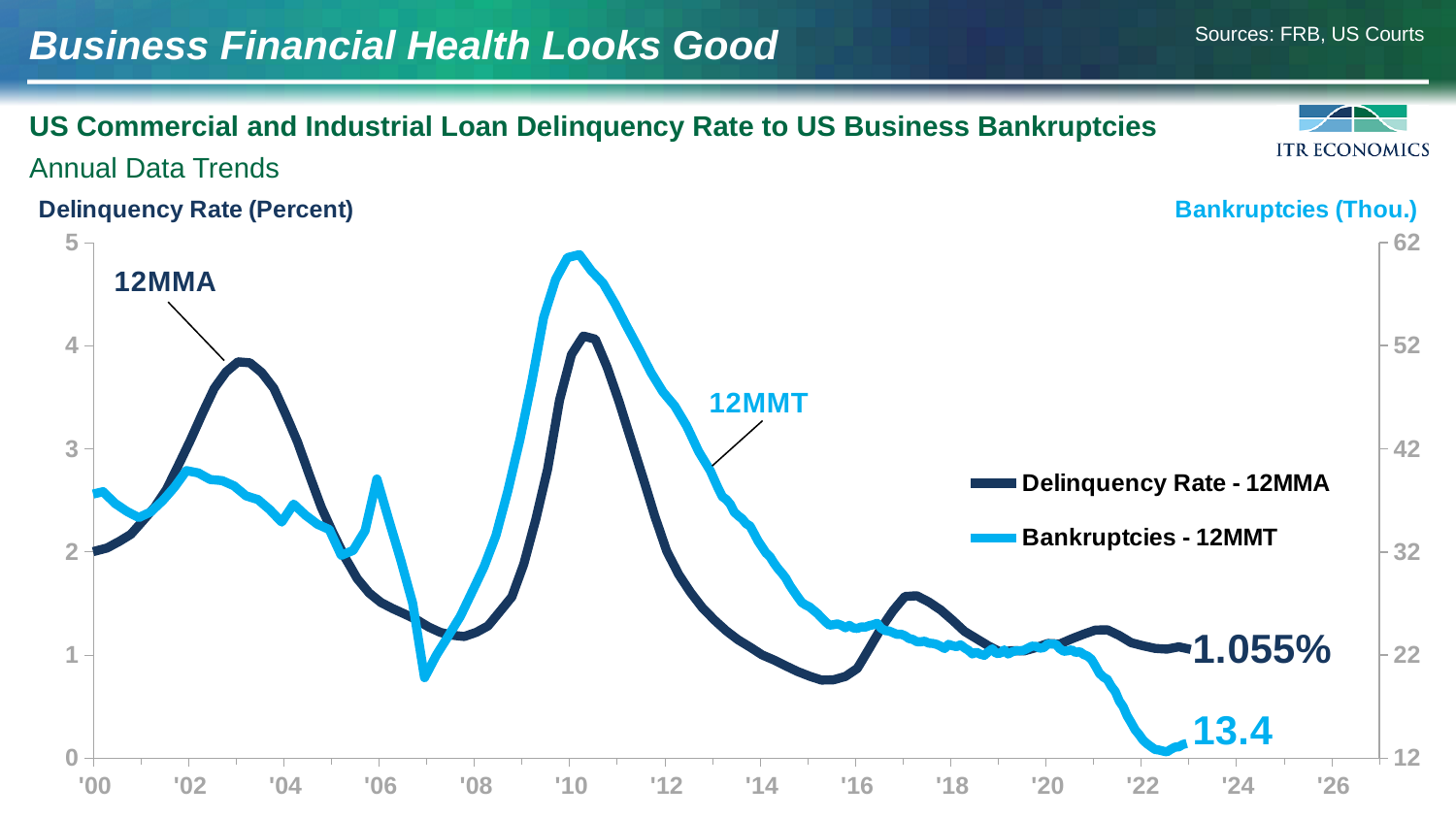
What is the latest value labeled for the Delinquency Rate - 12MMA series? 1.055% What is the label of the right-hand vertical axis? Bankruptcies (Thou.) Does the Delinquency Rate - 12MMA series rise or fall between '10 and '15? fall What is the latest value labeled for the Bankruptcies - 12MMT series? 13.4 What is the title of the chart? US Commercial and Industrial Loan Delinquency Rate to US Business Bankruptcies Is the peak value of the Bankruptcies - 12MMT series around '10 greater or less than 52? greater What kind of chart is shown on the slide? line chart Is the peak value of the Delinquency Rate - 12MMA series around '03 greater or less than 3? greater Is the value of the Bankruptcies - 12MMT series around '07 greater or less than 22? less How many series does the legend list? 2 Does the Bankruptcies - 12MMT series rise or fall between '20 and '22? fall